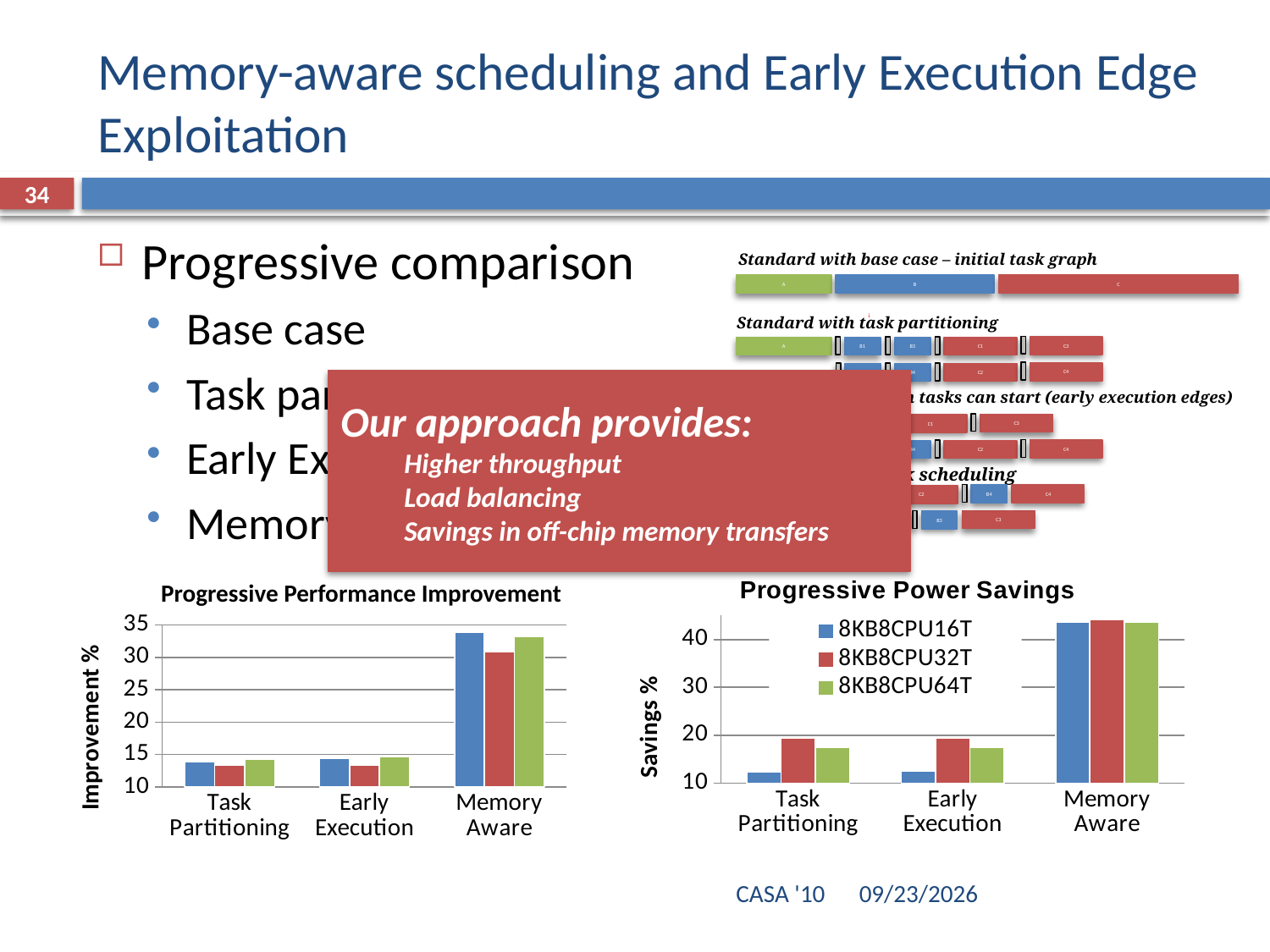
In the "Progressive Power Savings" chart, is the value for Memory Aware for 8KB8CPU32T greater or less than 40? greater In the "Progressive Performance Improvement" chart, is the value for Task Partitioning for the red series greater or less than 15? less What is the y-axis label of the "Progressive Power Savings" chart? Savings % How many categories are shown on the x axis of the "Progressive Power Savings" chart? 3 In the "Progressive Performance Improvement" chart, is the value for Memory Aware for the blue series greater or less than 30? greater In the "Progressive Performance Improvement" chart, which is larger for Memory Aware: the blue series or the red series? the blue series In the "Progressive Power Savings" chart, which is larger for Task Partitioning: 8KB8CPU16T or 8KB8CPU32T? 8KB8CPU32T In the "Progressive Power Savings" chart, which category has the highest savings? Memory Aware In the "Progressive Performance Improvement" chart, which category has the highest improvement? Memory Aware How many series does the legend of the "Progressive Power Savings" chart list? 3 What kind of chart is the "Progressive Performance Improvement" chart? bar chart